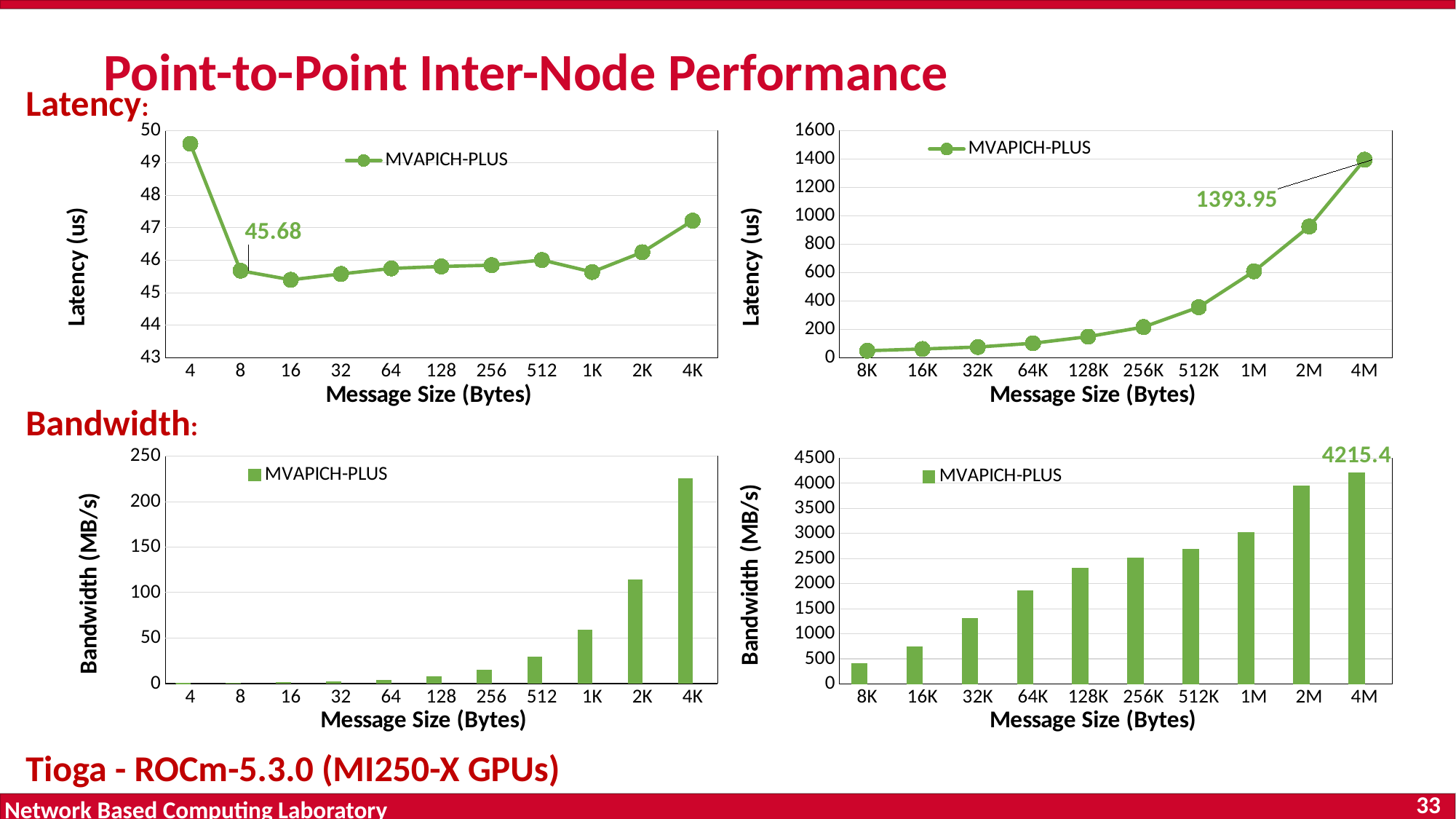
In the top-left latency chart, what is the latency for a message size of 8 bytes? 45.68 In the top-left latency chart, which message size has the highest latency? 4 In the bottom-left bandwidth chart, which has higher bandwidth: 1K bytes or 2K bytes? 2K In the top-right latency chart, does latency rise or fall as message size increases? rises In the bottom-right bandwidth chart, is the bandwidth for 2M bytes greater or less than 3500? greater What kind of chart is the bottom-left bandwidth chart? bar chart In the top-right latency chart, which message size has the lowest latency? 8K How many message sizes are plotted in the bottom-right bandwidth chart? 10 In the top-right latency chart, what is the latency for a message size of 4M bytes? 1393.95 In the top-right latency chart, is the latency for 1M bytes greater or less than 800? less In the bottom-left bandwidth chart, which message size has the highest bandwidth? 4K In the bottom-right bandwidth chart, what is the bandwidth for a message size of 4M bytes? 4215.4